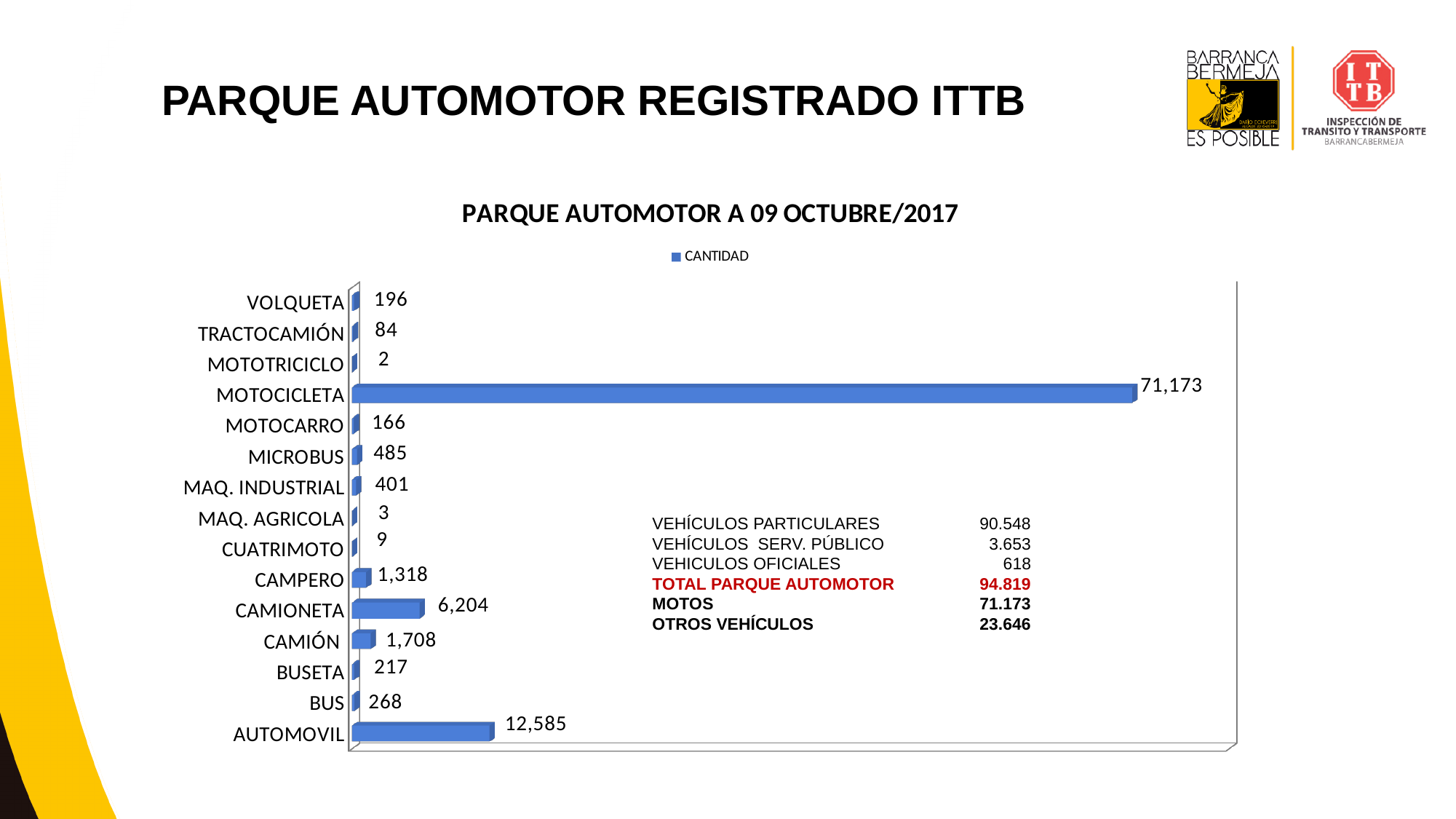
What kind of chart is shown? Bar chart What is the value for MOTOCICLETA? 71,173 How many series does the legend list? 1 What is the value for AUTOMOVIL? 12,585 Which is larger, the value for CAMIÓN or the value for CAMPERO? CAMIÓN What is the difference between the values for AUTOMOVIL and CAMIONETA? 6,381 What is the value for MAQ. INDUSTRIAL? 401 Which category has the highest value? MOTOCICLETA What is the title of the chart? PARQUE AUTOMOTOR A 09 OCTUBRE/2017 Which category has the lowest value? MOTOTRICICLO How many categories are shown in the chart? 15 What is the value for CAMIONETA? 6,204